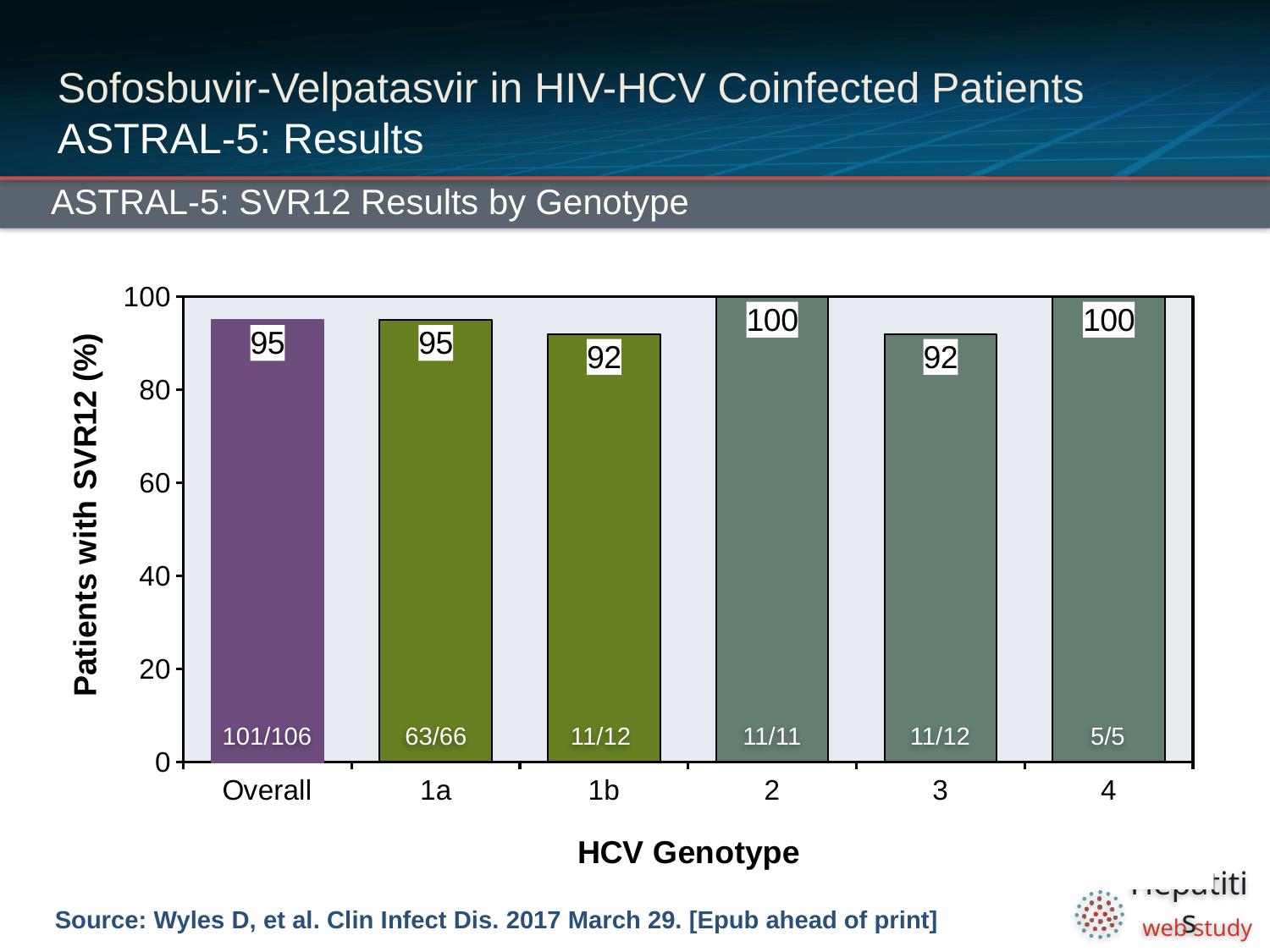
What is the SVR12 rate for HCV genotype 3? 92 Which genotypes have the lowest SVR12 rate? 1b and 3 Which genotypes have the highest SVR12 rate? 2 and 4 What is the SVR12 rate for HCV genotype 1b? 92 What kind of chart is shown on the slide? Bar chart What is the SVR12 rate for the Overall group? 95 What is the difference in SVR12 rate between genotype 2 and genotype 3? 8 How many categories are shown on the x axis? 6 Is the SVR12 rate for genotype 1a greater or less than 80? greater What fraction of patients is shown inside the bar for genotype 1a? 63/66 What is the label of the y axis? Patients with SVR12 (%) What fraction of patients is shown inside the Overall bar? 101/106